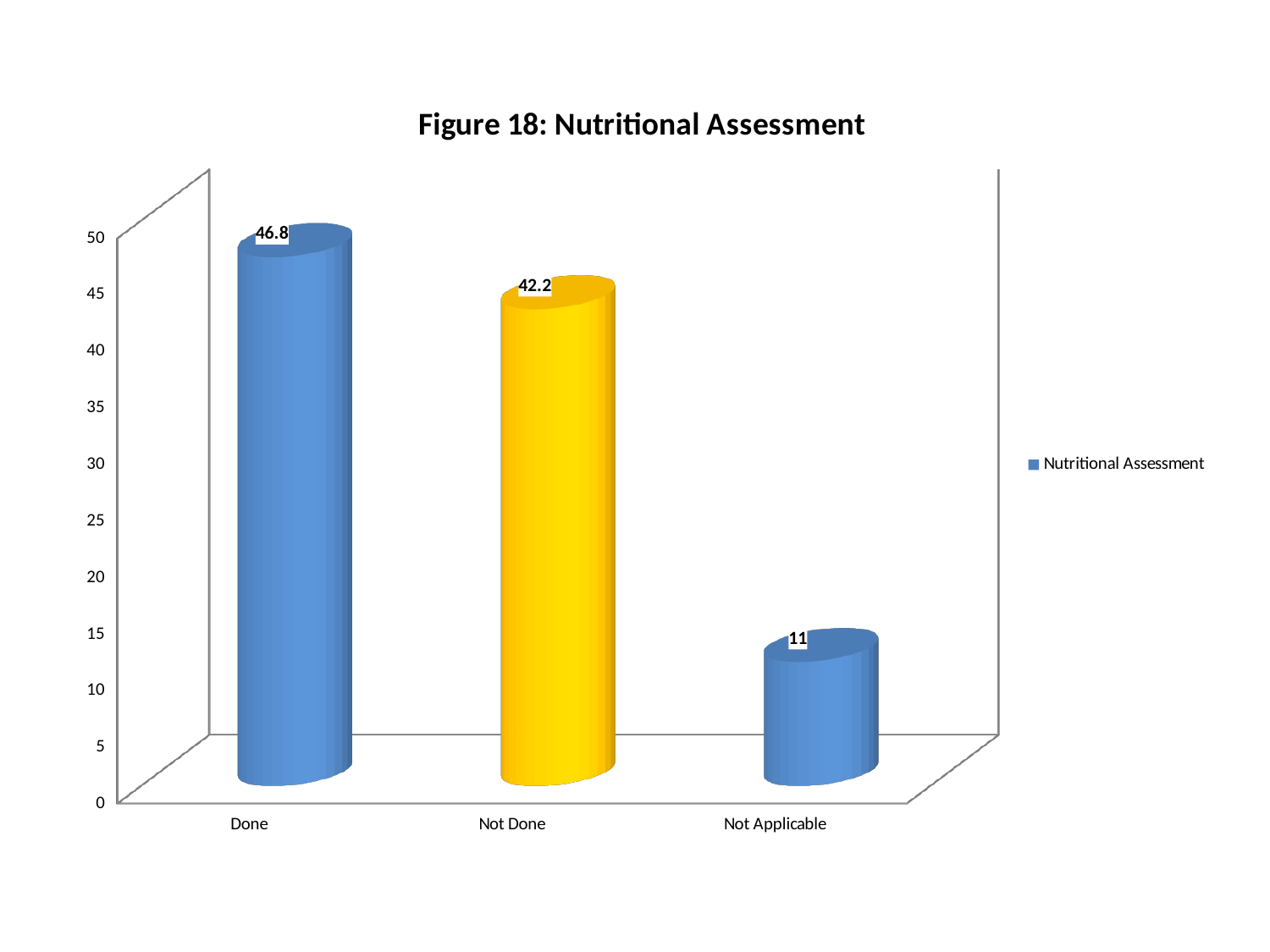
What kind of chart is shown? Bar chart How many categories are shown on the x axis? 3 What is the value for Not Done? 42.2 What is the value for Done? 46.8 What is the difference between the values for Done and Not Done? 4.6 Which category has the lowest value? Not Applicable How many series does the legend list? 1 What is the difference between the values for Not Done and Not Applicable? 31.2 Which is larger, the value for Done or the value for Not Applicable? Done Which category has the highest value? Done What is the value for Not Applicable? 11 What is the title of the chart? Figure 18: Nutritional Assessment